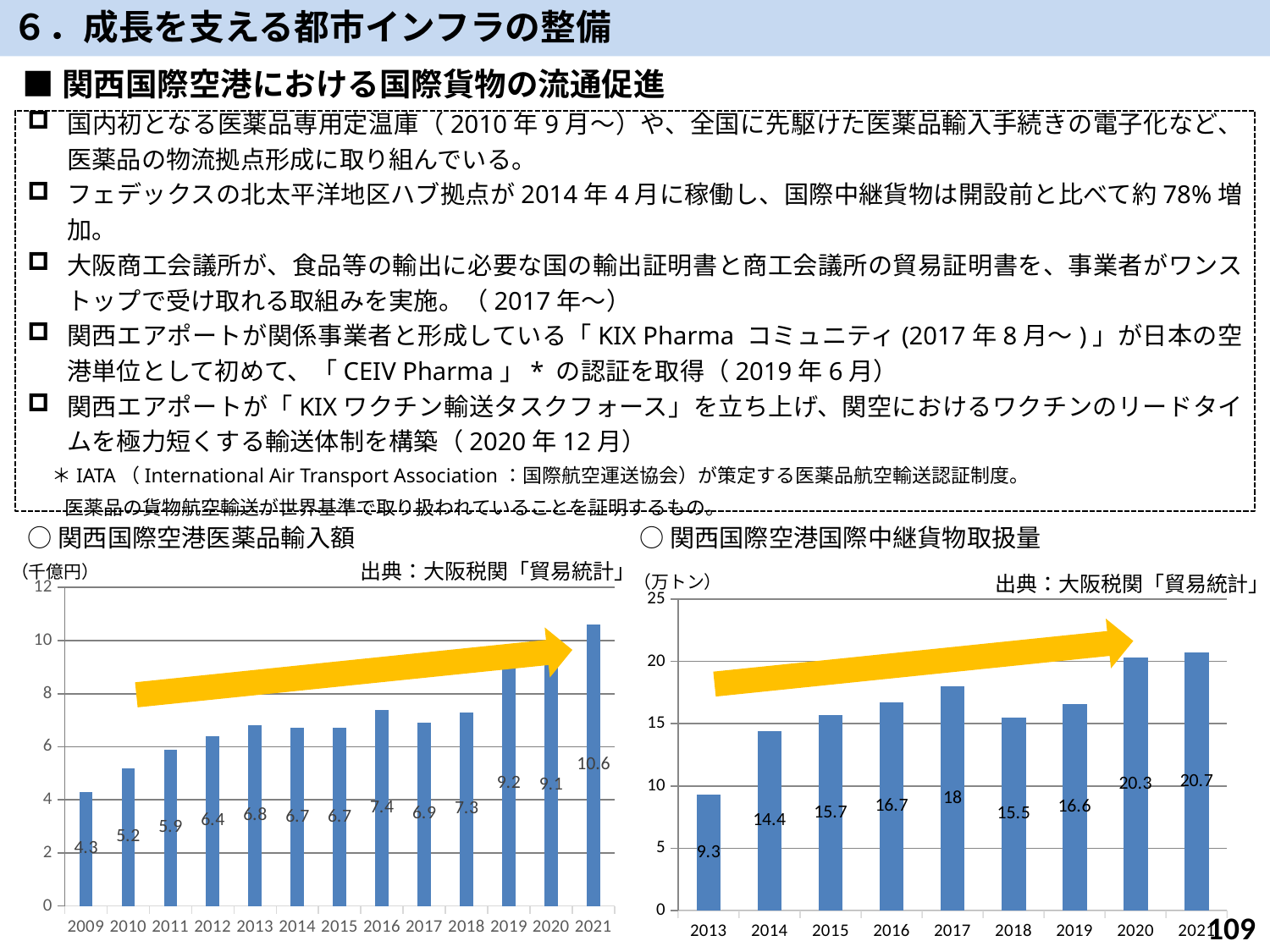
In the right chart (関西国際空港国際中継貨物取扱量), what is the value for 2017? 18 In the left chart (関西国際空港医薬品輸入額), which year has the lowest value? 2009 In the left chart (関西国際空港医薬品輸入額), how many years are plotted? 13 In the left chart (関西国際空港医薬品輸入額), which year has the highest value? 2021 In the left chart (関西国際空港医薬品輸入額), what is the difference between the values for 2021 and 2020? 1.5 In the right chart (関西国際空港国際中継貨物取扱量), which year has the highest value? 2021 In the right chart (関西国際空港国際中継貨物取扱量), which is larger, the value for 2017 or the value for 2018? 2017 What type of chart is the right chart (関西国際空港国際中継貨物取扱量)? Bar chart In the right chart (関西国際空港国際中継貨物取扱量), what is the value for 2013? 9.3 In the right chart (関西国際空港国際中継貨物取扱量), what is the difference between the values for 2020 and 2013? 11 In the left chart (関西国際空港医薬品輸入額), what is the value for 2009? 4.3 In the left chart (関西国際空港医薬品輸入額), what is the value for 2021? 10.6